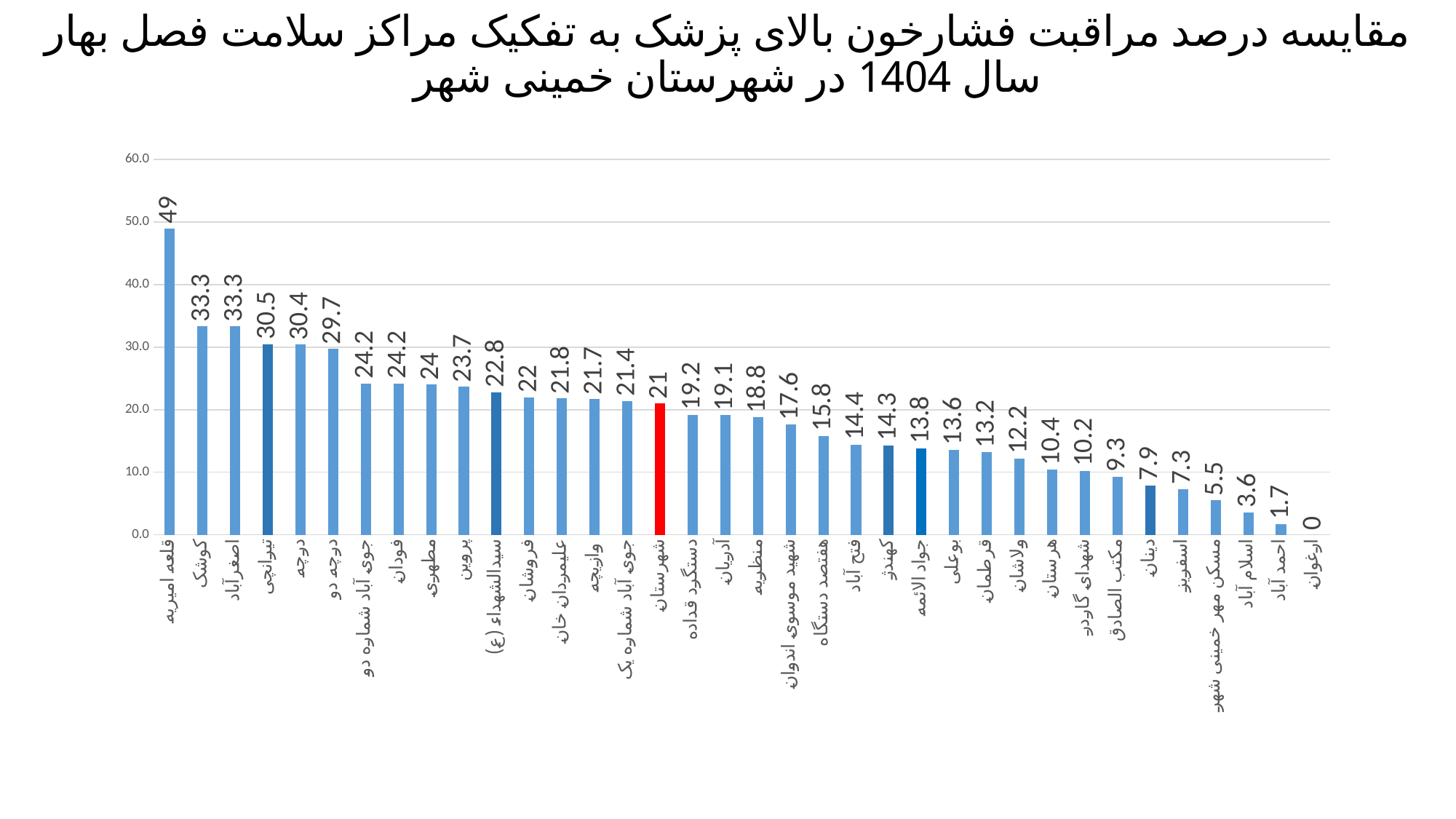
What is the value for مسکن مهر خمینی شهر? 5.5 Which health centre has the lowest value? ارغوان What is the value for تیرانچی? 30.5 What type of chart is shown on the slide? bar chart What is the value for قلعه امیریه? 49 Do the values generally rise or fall from left to right along the x axis? fall What is the value for the red bar labelled شهرستان? 21 Which is larger, the value for درچه or the value for درچه دو? درچه What is the difference between the values for قلعه امیریه and کوشک? 15.7 Is the value for هفتصد دستگاه greater or less than 20.0? less Which health centre has the highest value? قلعه امیریه How many health centres (bars) are shown in the chart? 36